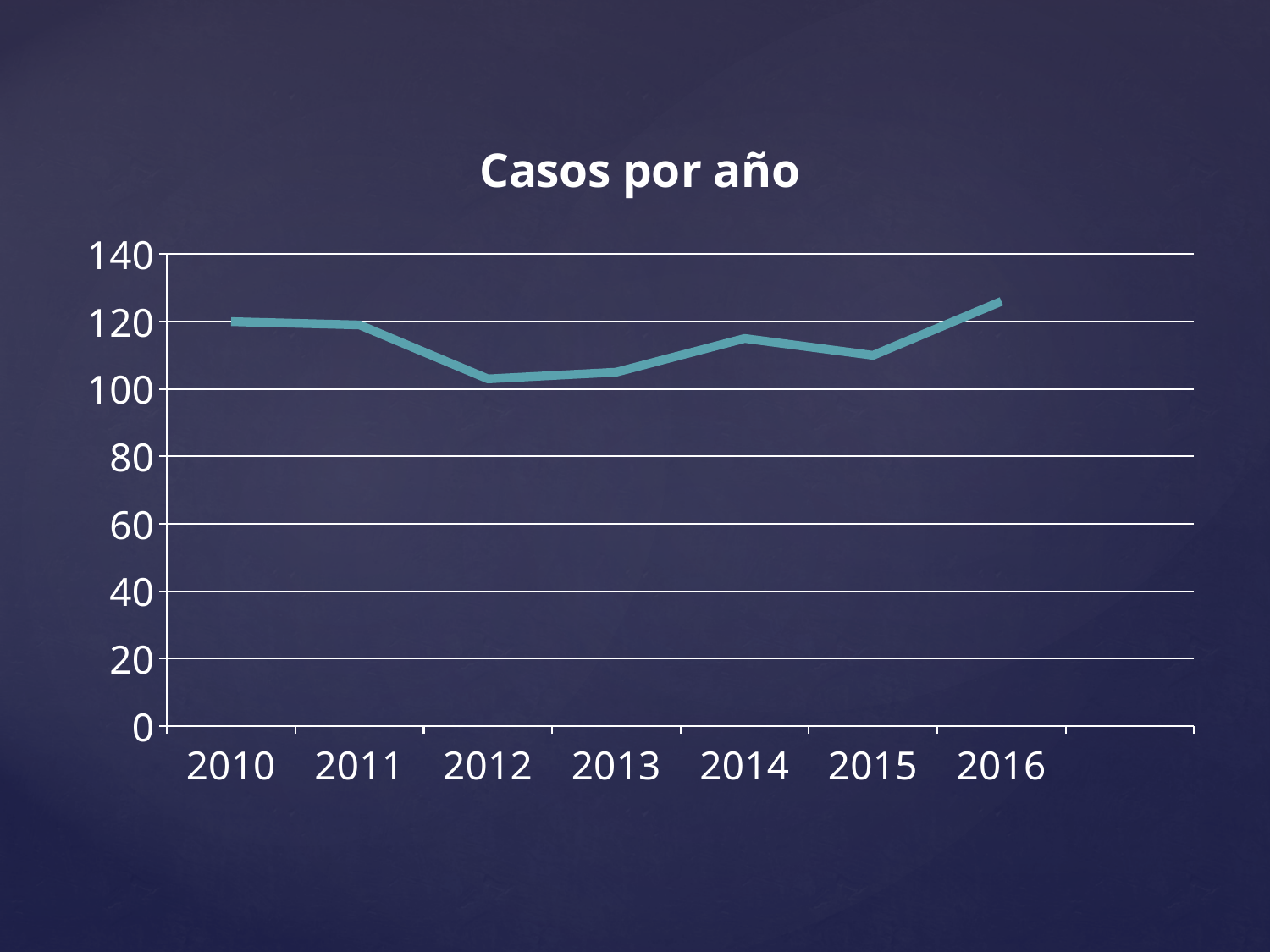
Which is larger, the value for 2010 or the value for 2012? 2010 Do the values rise or fall from 2015 to 2016? rise Is the value for 2014 greater or less than 100? greater Is the value for 2012 greater or less than 120? less How many years are plotted on the x axis of the chart? 7 Which year has the highest value in the chart? 2016 What is the title of the chart? Casos por año What type of chart is shown on the slide? line chart Do the values rise or fall from 2010 to 2012? fall Is the value for 2015 greater or less than 120? less Which is larger, the value for 2014 or the value for 2015? 2014